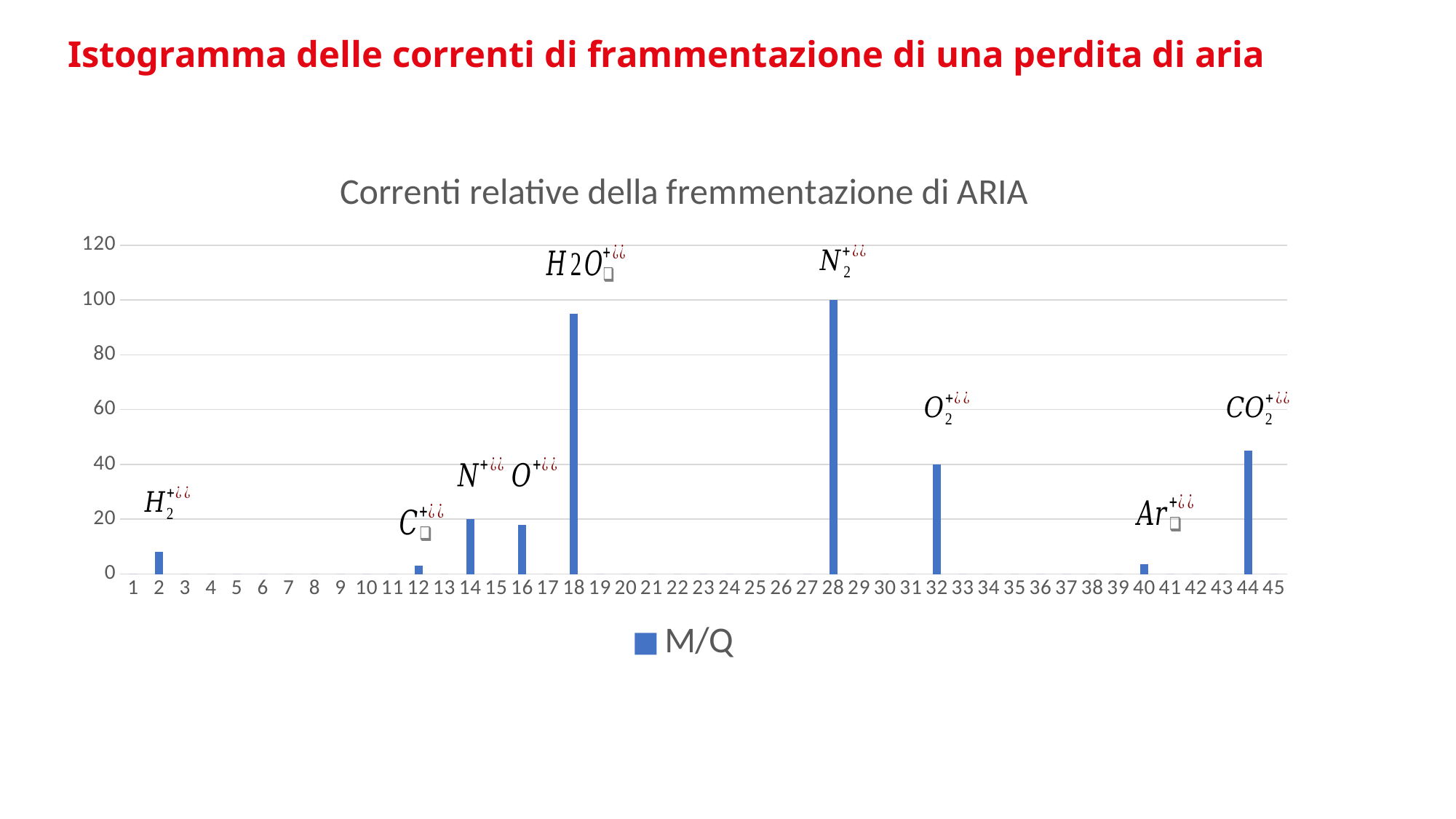
Which bar is taller, the one at x = 18 or the one at x = 28? 28 What is the value of the bar at x = 28? 100 Which x-axis category has the highest bar? 28 Is the value of the bar at x = 18 greater or less than 80? greater What is the value of the bar at x = 32? 40 What is the difference between the bar at x = 28 and the bar at x = 32? 60 Is the value of the bar at x = 2 greater or less than 20? less What kind of chart is shown on the slide? bar chart Is the value of the bar at x = 44 greater or less than 60? less Which bar is taller, the one at x = 32 or the one at x = 18? 18 What is the title of the chart? Correnti relative della fremmentazione di ARIA How many series does the legend list? 1